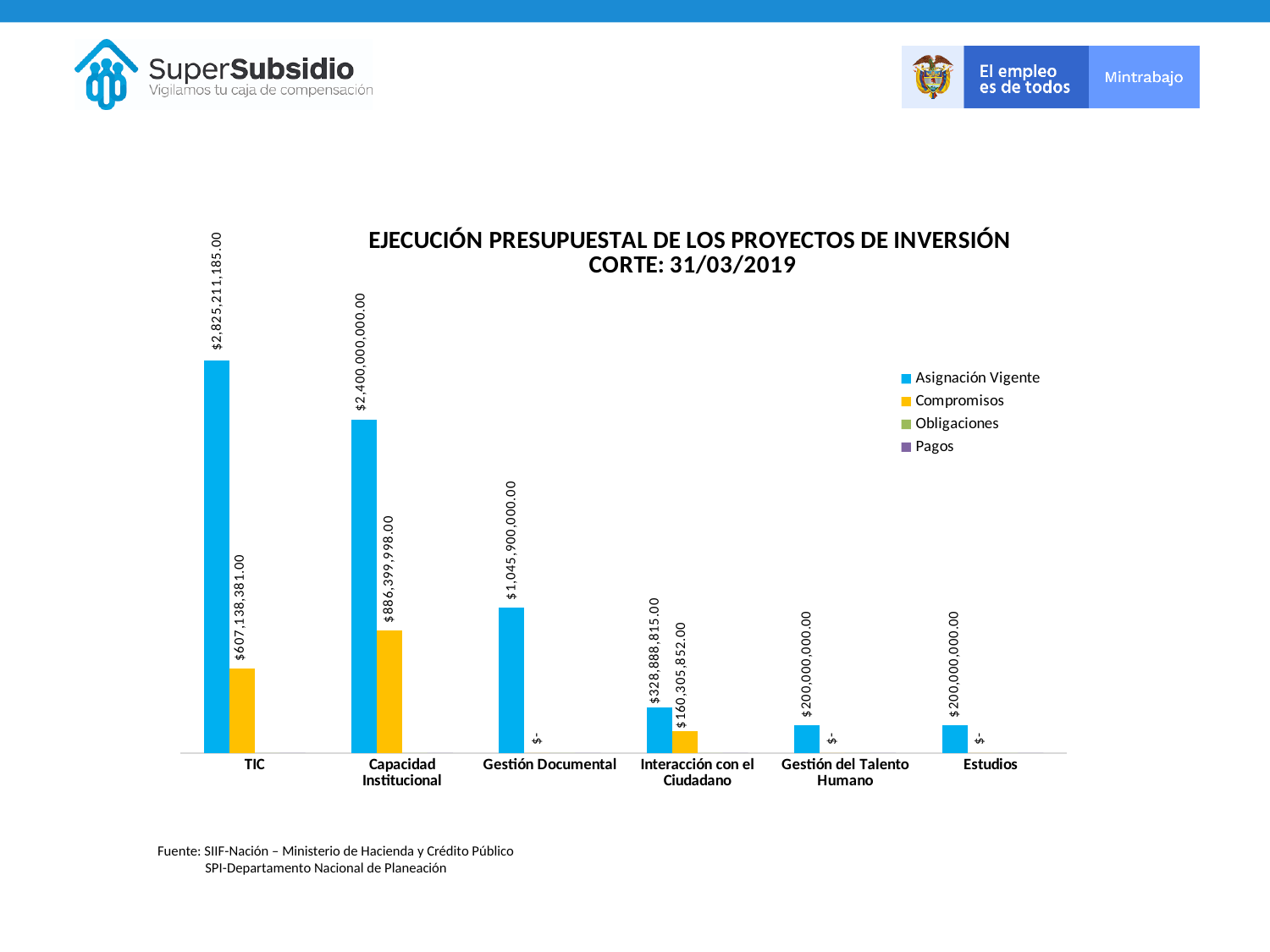
How many categories are shown on the x axis? 6 Which is larger, the Asignación Vigente for Capacidad Institucional or for Gestión Documental? Capacidad Institucional What is the Compromisos value for Capacidad Institucional? $886,399,998.00 What is the Asignación Vigente value for Gestión Documental? $1,045,900,000.00 Which category has the highest Asignación Vigente? TIC What is the Asignación Vigente value for Gestión del Talento Humano? $200,000,000.00 How many series does the legend list? 4 What is the difference between Asignación Vigente and Compromisos for Interacción con el Ciudadano? $168,582,963.00 What is the Compromisos value for Interacción con el Ciudadano? $160,305,852.00 What is the Asignación Vigente value for TIC? $2,825,211,185.00 What is the difference between Asignación Vigente and Compromisos for TIC? $2,218,072,804.00 Which category has the highest Compromisos value? Capacidad Institucional